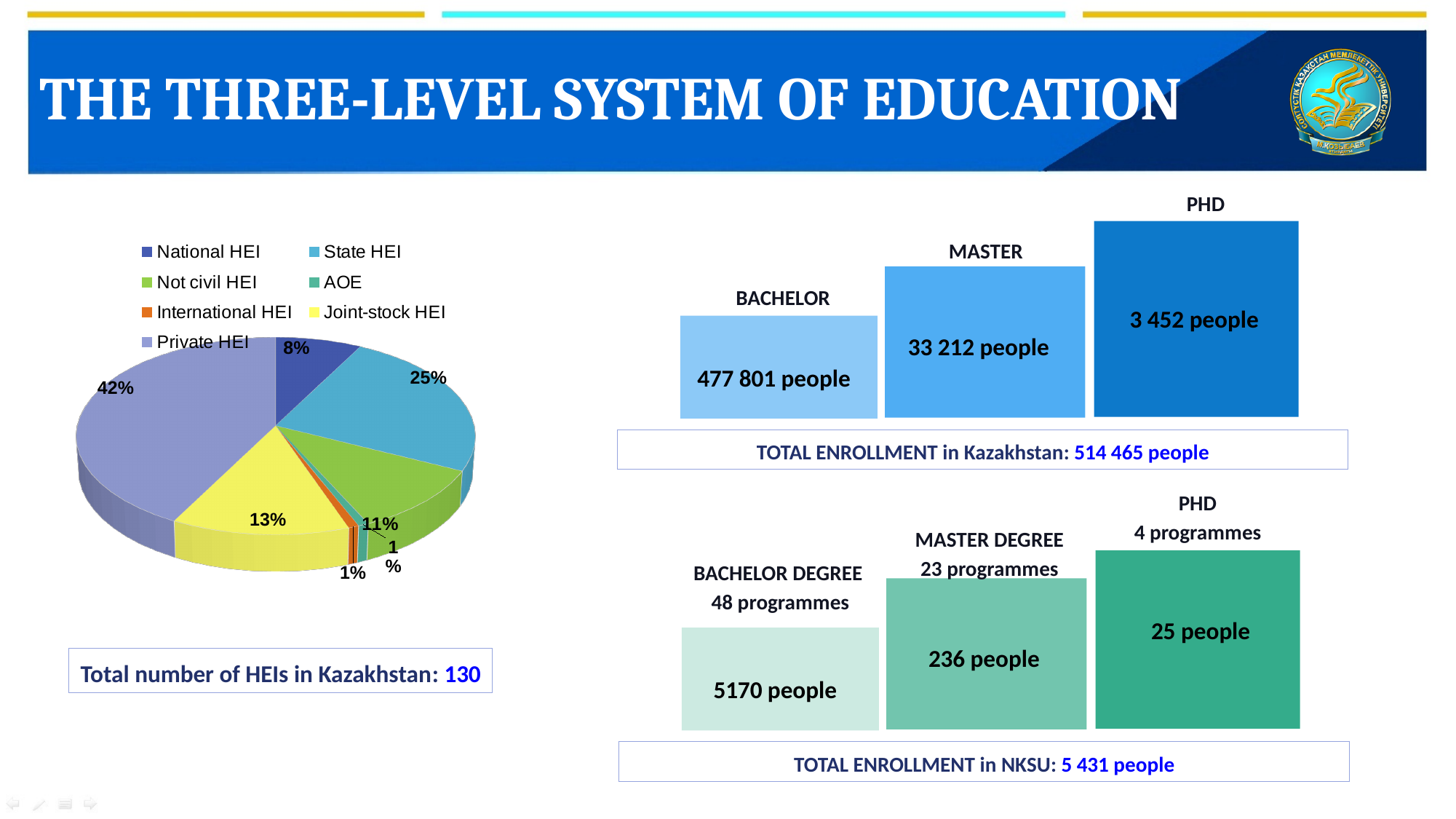
What colour is the Joint-stock HEI slice in the pie chart? Yellow How many categories does the pie chart legend list? 7 In the pie chart, what share is labelled for Not civil HEI? 11% In the pie chart, by how many percentage points does Private HEI exceed State HEI? 17 percentage points Which two categories share the smallest slice in the pie chart? AOE and International HEI In the pie chart, what share is labelled for Joint-stock HEI? 13% What kind of chart is shown on the left of the slide? Pie chart In the pie chart, what share is labelled for National HEI? 8% In the pie chart, what share is labelled for Private HEI? 42% In the pie chart, which is larger: State HEI or Joint-stock HEI? State HEI Which category has the largest slice in the pie chart? Private HEI In the pie chart, what share is labelled for State HEI? 25%